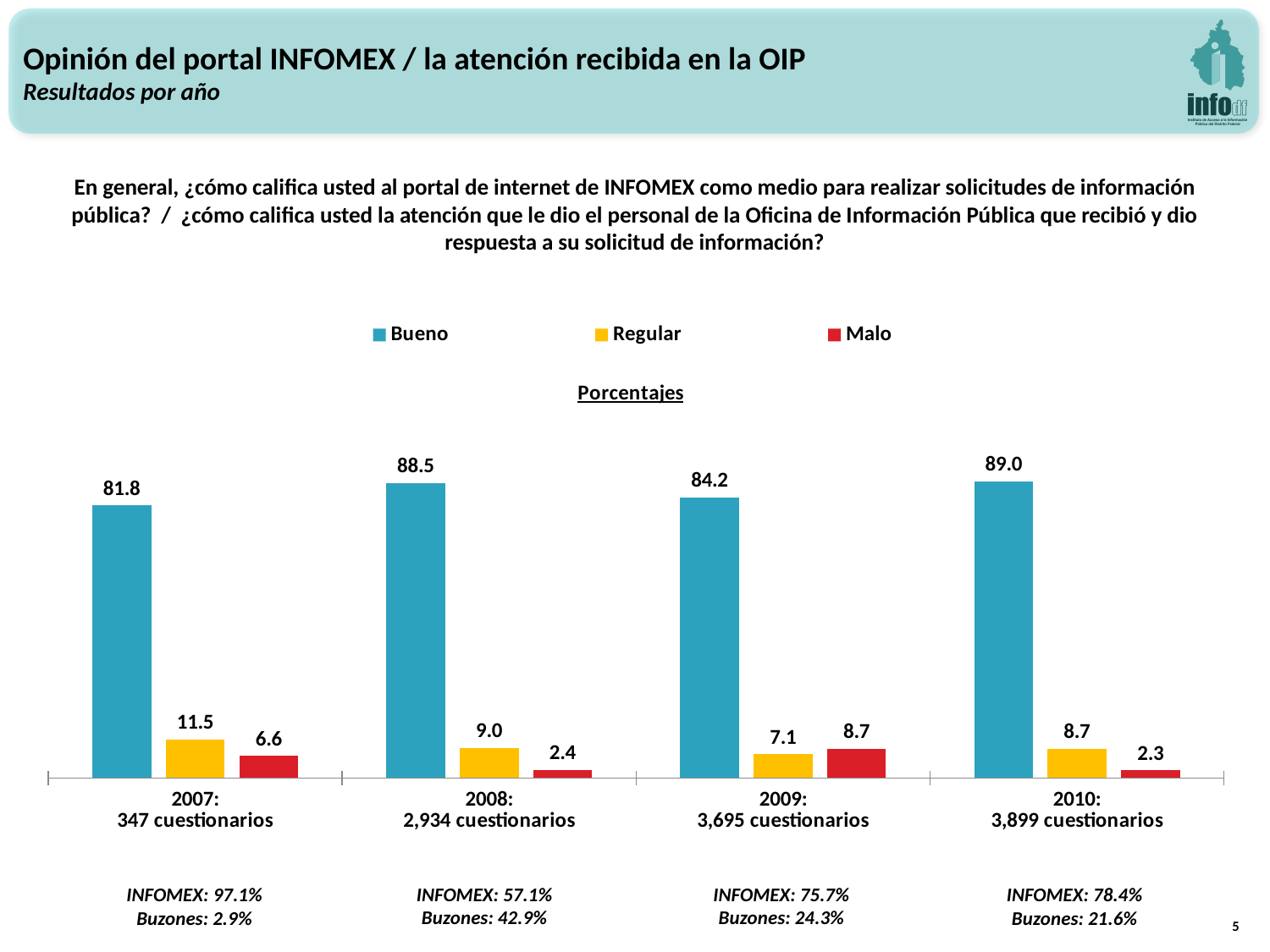
Does the Regular value rise or fall from 2007 to 2010? Fall What is the value for Regular in 2007? 11.5 How many years (categories) are shown on the x axis? 4 How many series does the legend list? 3 Which is larger, the Regular value in 2009 or the Malo value in 2009? Malo (8.7) What kind of chart is shown? Bar chart What is the difference between the Bueno values for 2010 and 2007? 7.2 In which year is the Malo value lowest? 2010 What is the value for Bueno in 2008? 88.5 In which year is the Bueno value highest? 2010 Which colour represents the Malo series in the legend? Red What is the value for Malo in 2009? 8.7